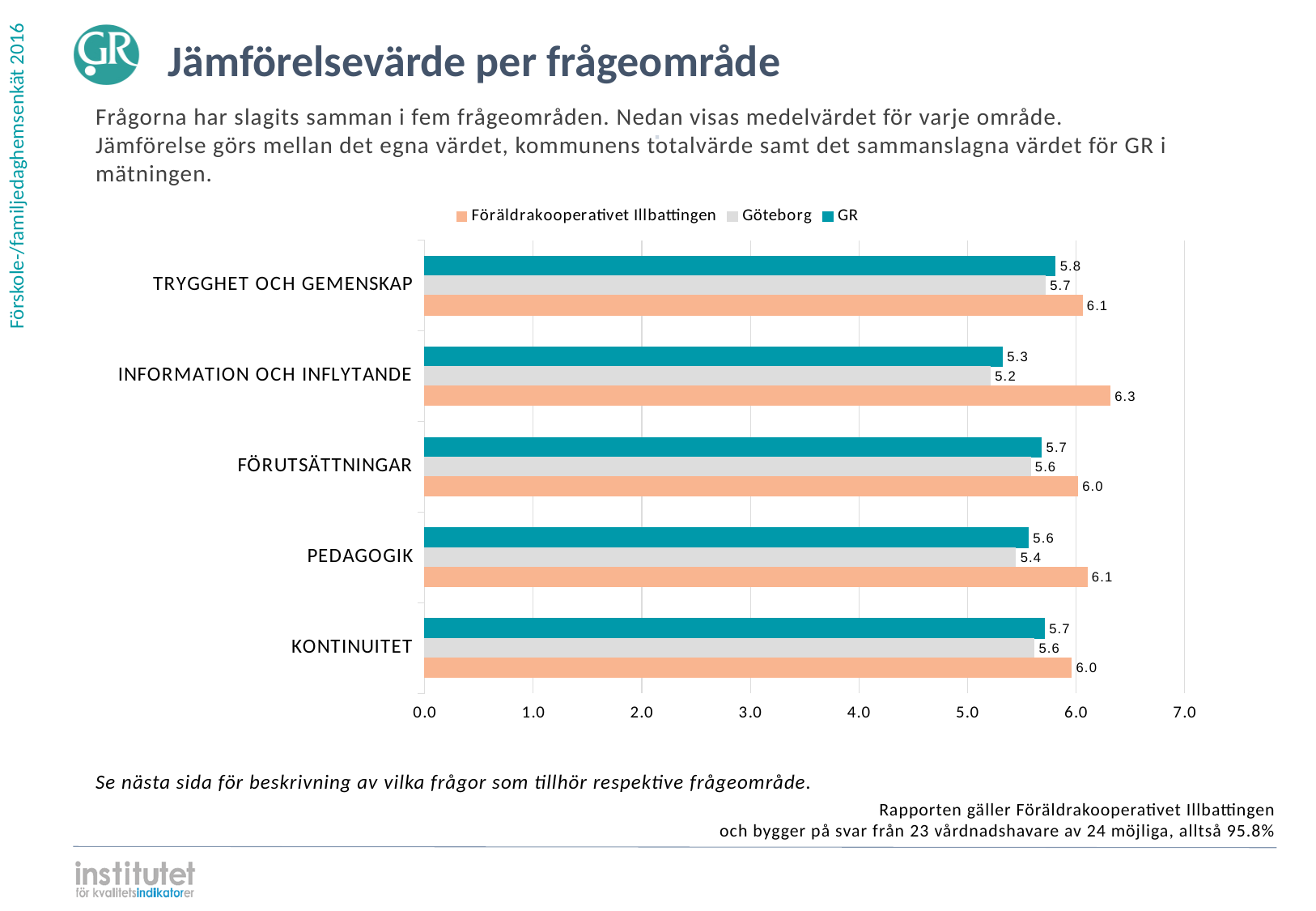
What is the difference between the Föräldrakooperativet Illbattingen value and the Göteborg value in the INFORMATION OCH INFLYTANDE category? 1.1 What is the value for GR in the TRYGGHET OCH GEMENSKAP category? 5.8 How many categories are shown on the chart? 5 What is the title of the chart on the slide? Jämförelsevärde per frågeområde What kind of chart is shown on the slide? Bar chart How many series does the legend list? 3 Which category has the highest value for Föräldrakooperativet Illbattingen? INFORMATION OCH INFLYTANDE Is the value for Föräldrakooperativet Illbattingen in the KONTINUITET category greater or less than 5.0? greater Which category has the lowest value for Göteborg? INFORMATION OCH INFLYTANDE What is the value for Föräldrakooperativet Illbattingen in the INFORMATION OCH INFLYTANDE category? 6.3 Which is larger in the PEDAGOGIK category: the value for GR or the value for Göteborg? GR What is the value for Göteborg in the PEDAGOGIK category? 5.4